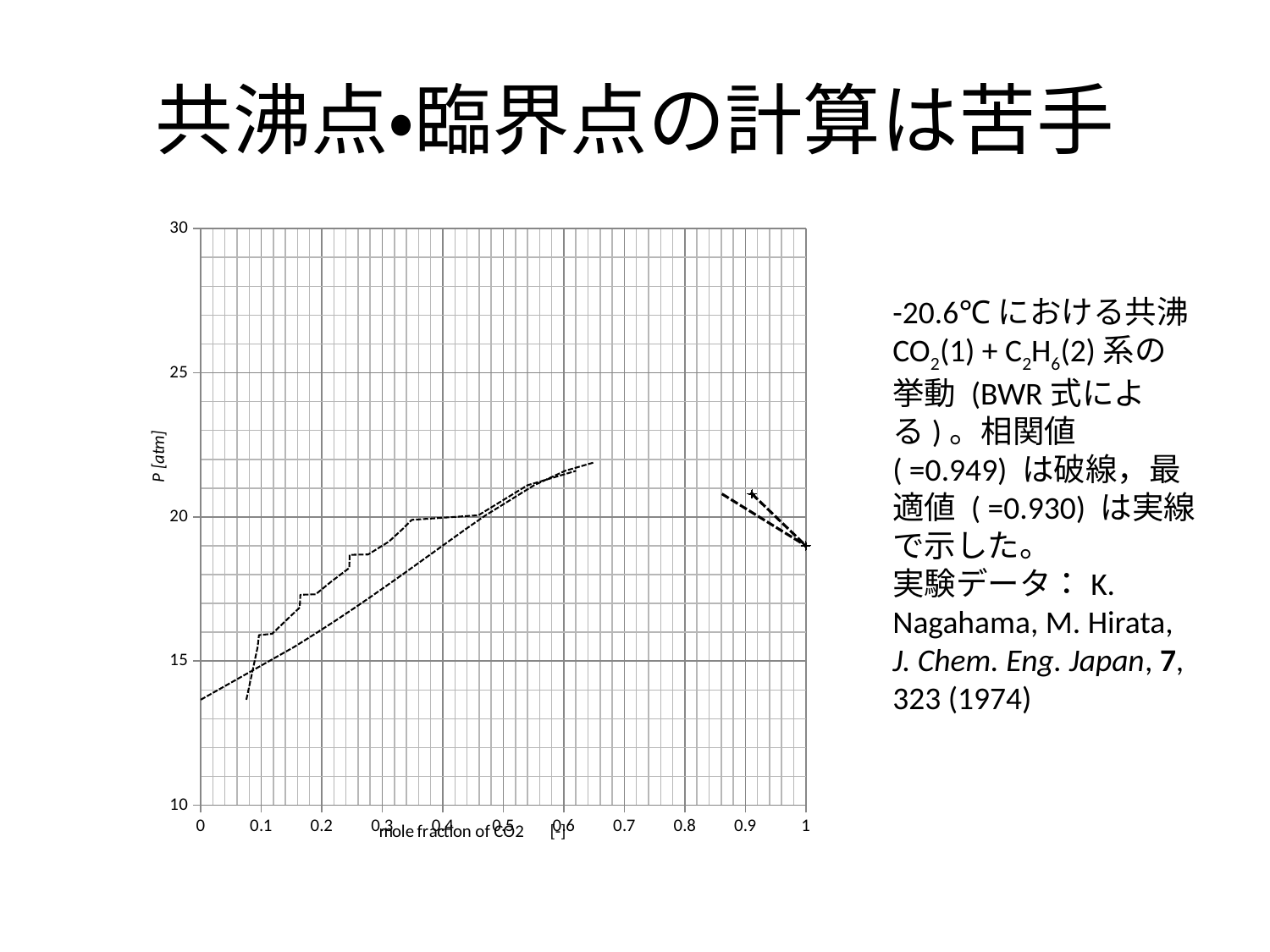
Does the pressure rise or fall as the CO2 mole fraction increases from 0 to 0.6? rise What is the label of the vertical axis of the chart? P [atm] What quantity is plotted on the horizontal axis of the chart? mole fraction of CO2 Is the pressure at a CO2 mole fraction of 0.6 greater or less than 20 atm? greater Is the pressure at a CO2 mole fraction of 0.9 greater or less than 20 atm? greater Is the pressure at a CO2 mole fraction of 1 greater or less than 20 atm? less What kind of chart is shown on the slide? line chart Which is larger, the pressure at a CO2 mole fraction of 0.6 or at a CO2 mole fraction of 0? 0.6 Does the pressure rise or fall as the CO2 mole fraction increases from 0.9 to 1? fall What is the highest value shown on the vertical axis of the chart? 30